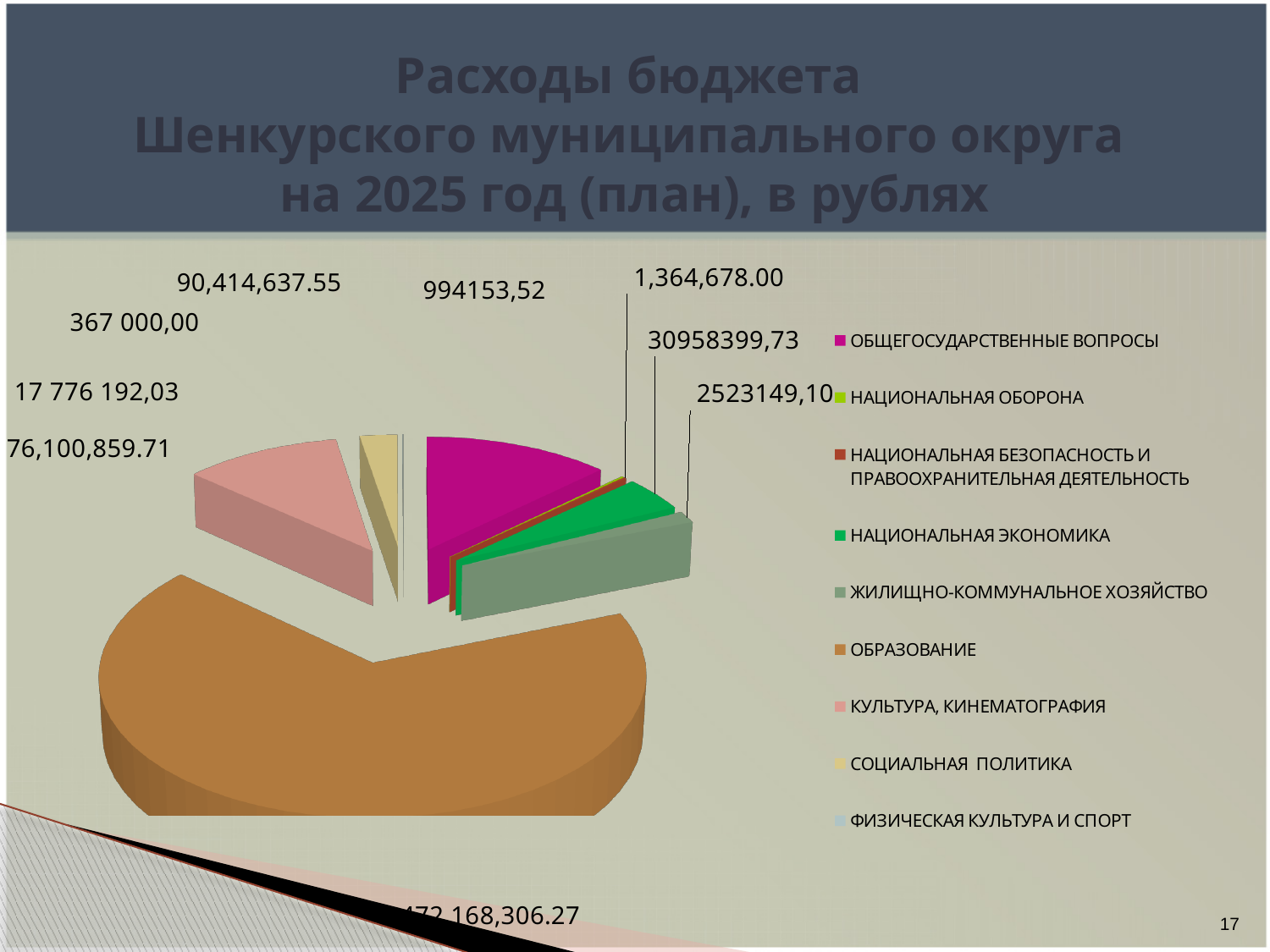
What type of chart is shown on the slide? pie chart What is the value for КУЛЬТУРА, КИНЕМАТОГРАФИЯ? 76,100,859.71 What is the value for ЖИЛИЩНО-КОММУНАЛЬНОЕ ХОЗЯЙСТВО? 2523149,10 Which is larger: the value for ОБРАЗОВАНИЕ or the value for КУЛЬТУРА, КИНЕМАТОГРАФИЯ? ОБРАЗОВАНИЕ How many categories does the legend list? 9 Which category has the largest share of the budget expenditures? ОБРАЗОВАНИЕ What is the value for СОЦИАЛЬНАЯ ПОЛИТИКА? 17 776 192,03 What is the smallest value printed on the chart? 367 000,00 What is the value for НАЦИОНАЛЬНАЯ ЭКОНОМИКА? 30958399,73 What is the planned expenditure for ОБРАЗОВАНИЕ? 472,168,306.27 What is the difference between the values for ОБЩЕГОСУДАРСТВЕННЫЕ ВОПРОСЫ and КУЛЬТУРА, КИНЕМАТОГРАФИЯ? 14,313,777.84 What is the value for ОБЩЕГОСУДАРСТВЕННЫЕ ВОПРОСЫ? 90,414,637.55